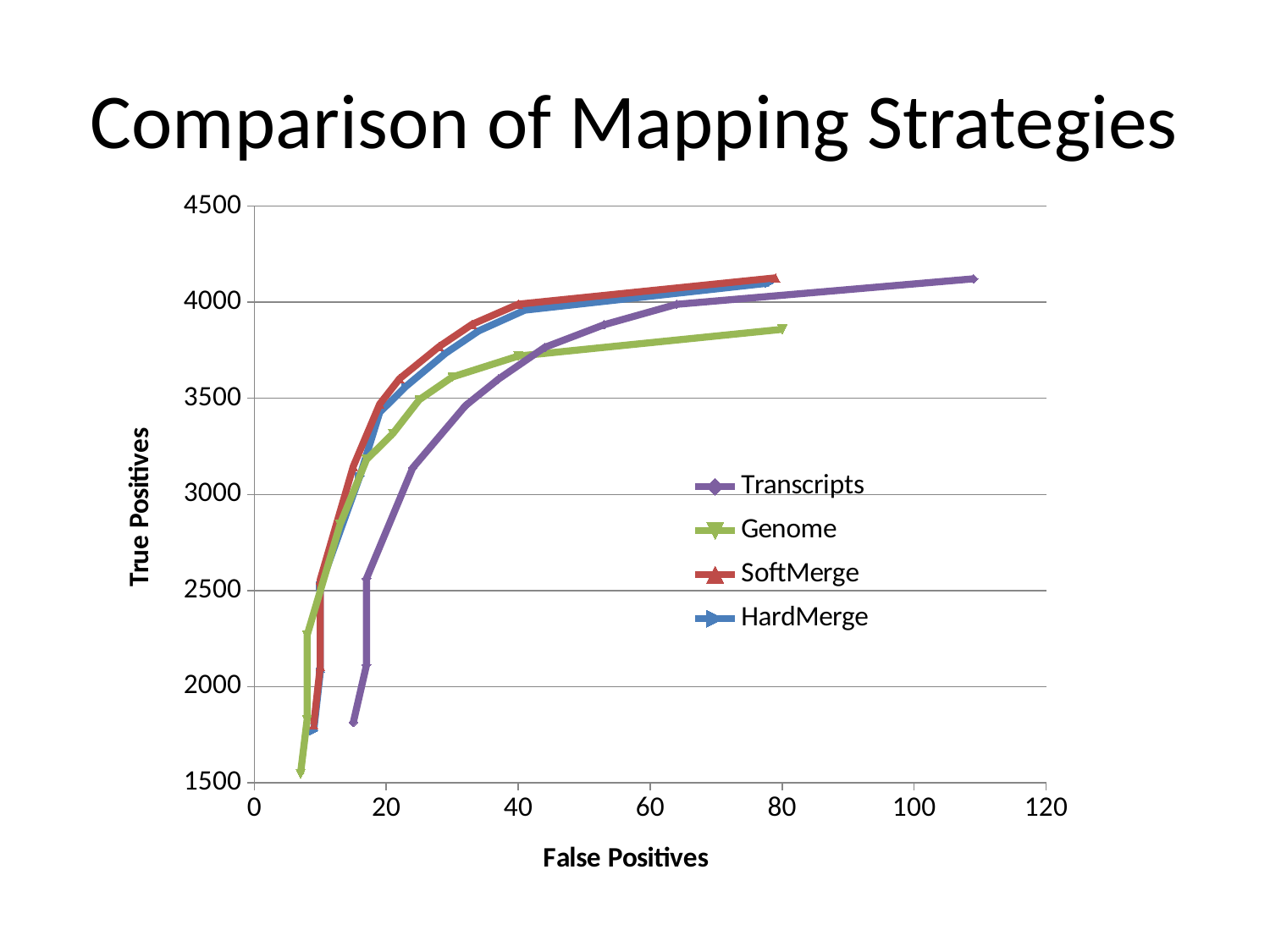
Is the lowest True Positives value of the Genome series greater or less than 2000? less As False Positives increase, do the True Positives values of the series rise or fall? rise Which series has the lowest True Positives value at its leftmost point? Genome What kind of chart is shown on the slide? line chart How many series does the legend list? 4 What is the title of the chart? Comparison of Mapping Strategies Is the largest False Positives value reached by the Transcripts series greater or less than 100? greater Which series extends to the largest False Positives value? Transcripts Is the highest True Positives value reached by the SoftMerge series greater or less than 4000? greater What is the label of the x axis? False Positives